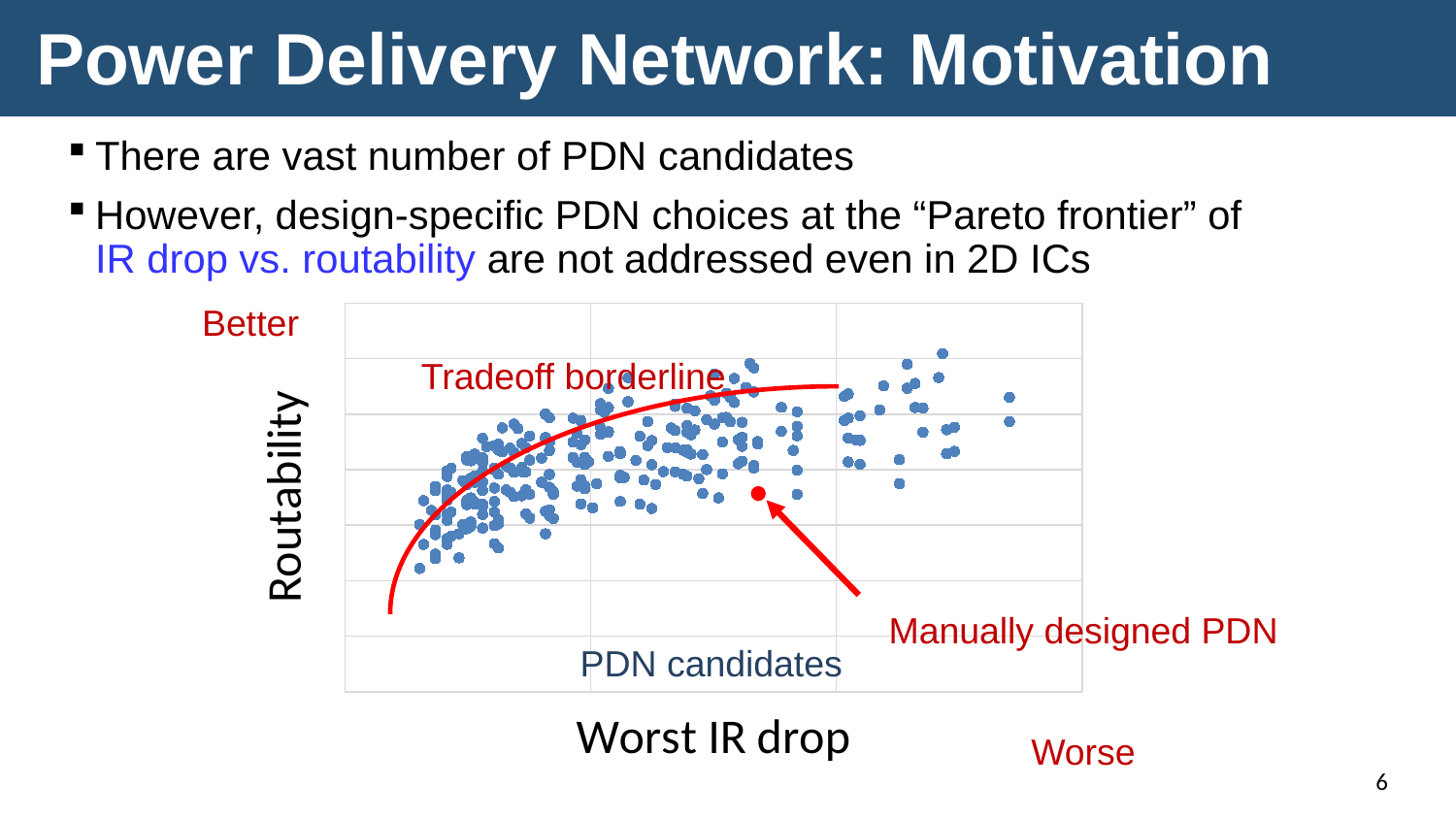
What does the single red point highlighted by the arrow represent? Manually designed PDN What does the red curve drawn over the scatter points represent, according to its label? Tradeoff borderline As Worst IR drop increases along the x axis, does Routability generally rise or fall? rise What is the label of the x axis of the chart? Worst IR drop What kind of chart is shown on the slide? scatter chart